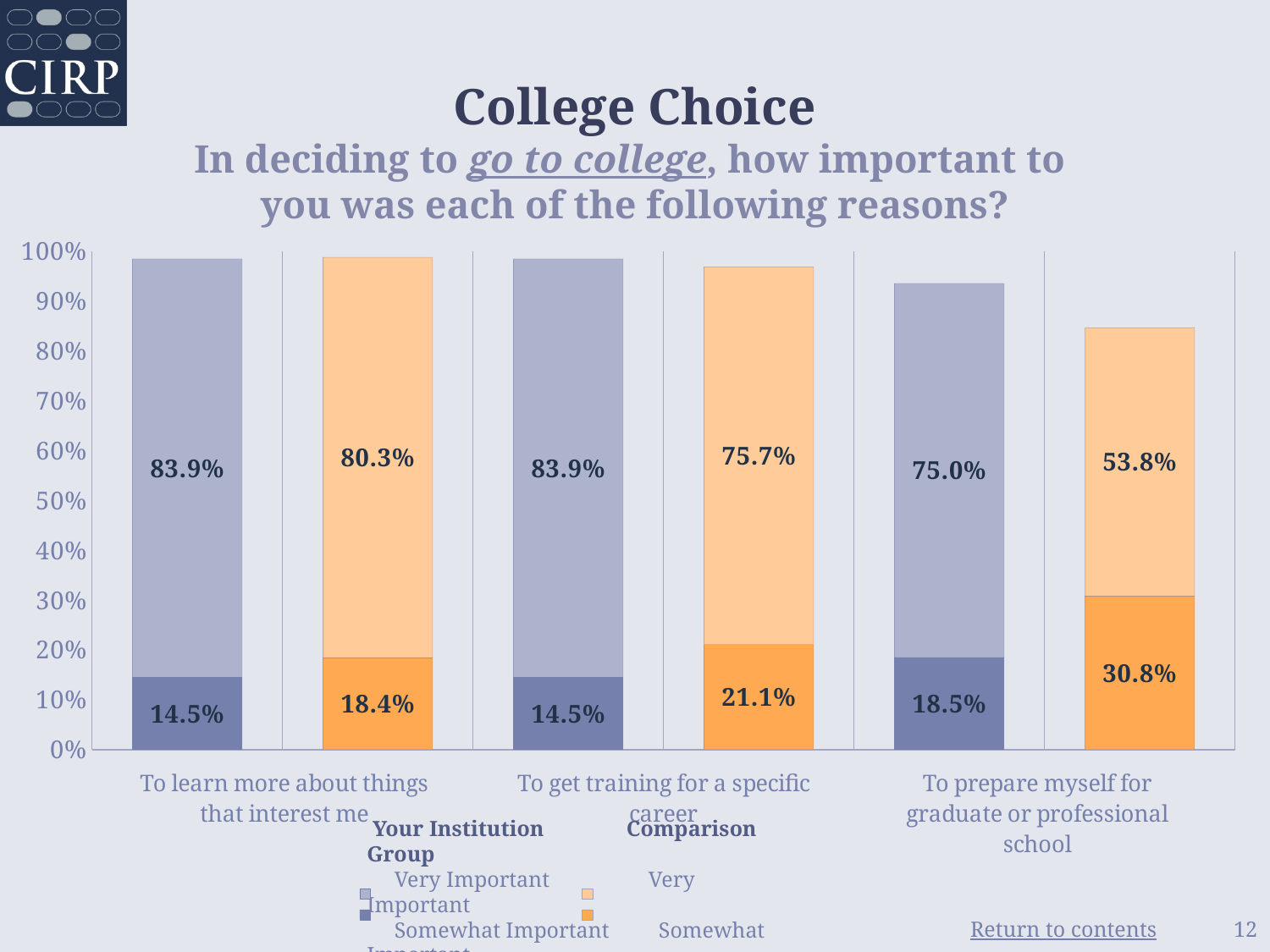
What percentage of the Comparison Group rated 'To prepare myself for graduate or professional school' as Very Important? 53.8% What is the combined Very Important and Somewhat Important total for Your Institution on 'To learn more about things that interest me'? 98.4% What is the combined Very Important and Somewhat Important total for the Comparison Group on 'To prepare myself for graduate or professional school'? 84.6% For 'To get training for a specific career', which group has the higher Very Important percentage, Your Institution or the Comparison Group? Your Institution What is the difference between the Your Institution and Comparison Group Very Important values for 'To prepare myself for graduate or professional school'? 21.2 percentage points Which reason has the lowest Very Important percentage for the Comparison Group? To prepare myself for graduate or professional school How many series does the chart's legend list? 4 Is the Comparison Group's Somewhat Important value for 'To prepare myself for graduate or professional school' greater or less than 30%? greater What is the Somewhat Important value for the Comparison Group on 'To get training for a specific career'? 21.1% What type of chart is shown on the slide? Stacked bar chart How many reasons (categories) are shown on the x axis of the chart? 3 What percentage of Your Institution students rated 'To learn more about things that interest me' as Very Important? 83.9%